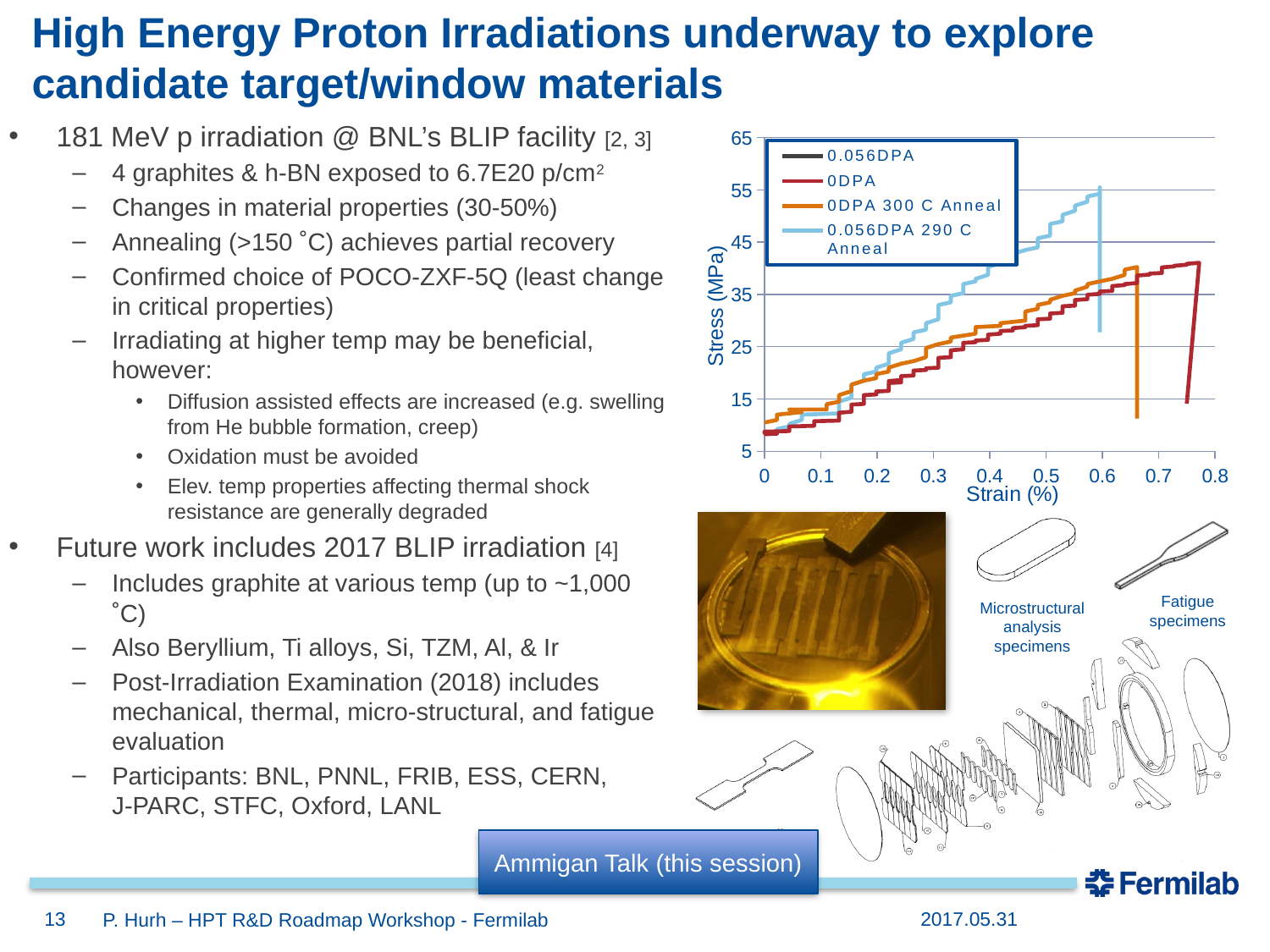
Which series extends to the largest strain on the chart? 0DPA Is the peak stress of the 0DPA series greater or less than 35 MPa? greater Is the maximum strain reached by the 0DPA series greater or less than 0.7%? greater Which series reaches the highest stress on the chart? 0.056DPA 290 C Anneal What kind of chart is shown on the slide? line chart Does stress rise or fall as strain increases along the 0DPA 300 C Anneal curve before it ends? rise Is the peak stress of the 0.056DPA 290 C Anneal series greater or less than 45 MPa? greater How many series does the chart's legend list? 4 Which series reaches a higher peak stress, 0.056DPA 290 C Anneal or 0DPA? 0.056DPA 290 C Anneal What is the label of the chart's y axis? Stress (MPa) What is the label of the chart's x axis? Strain (%)